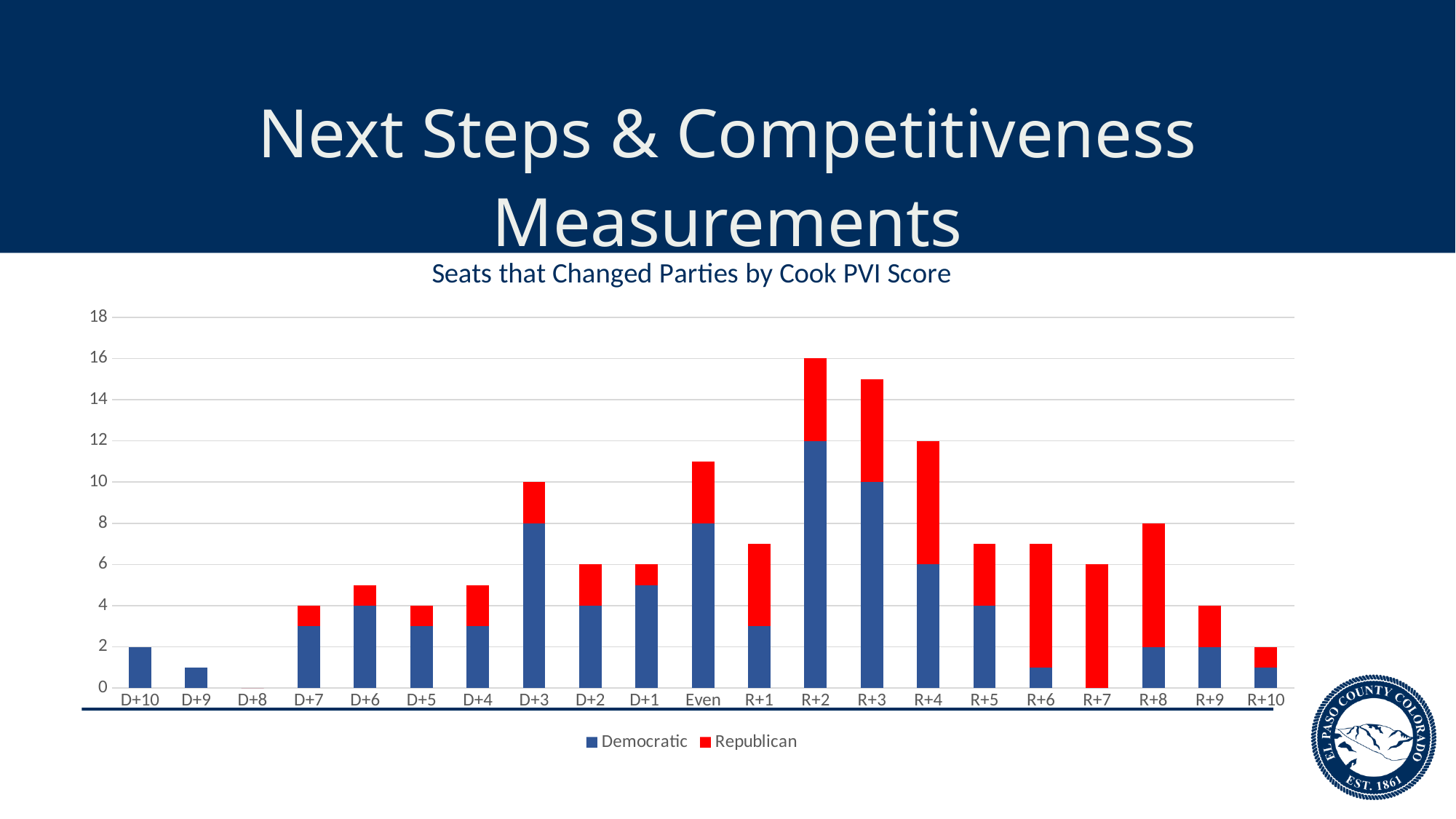
What is the title of the chart? Seats that Changed Parties by Cook PVI Score Is the total for Even greater or less than 10? greater Which Cook PVI category has the tallest stacked bar? R+2 Which is larger, the total for R+3 or the total for R+4? R+3 Which Cook PVI category has no bar at all? D+8 What kind of chart is shown on the slide? bar chart What is the Democratic value for R+2? 12 What is the Democratic value for D+3? 8 How many Cook PVI categories are shown on the x axis? 21 What is the total height of the stacked bar for R+4? 12 How many series does the legend list? 2 What is the total height of the stacked bar for R+2? 16